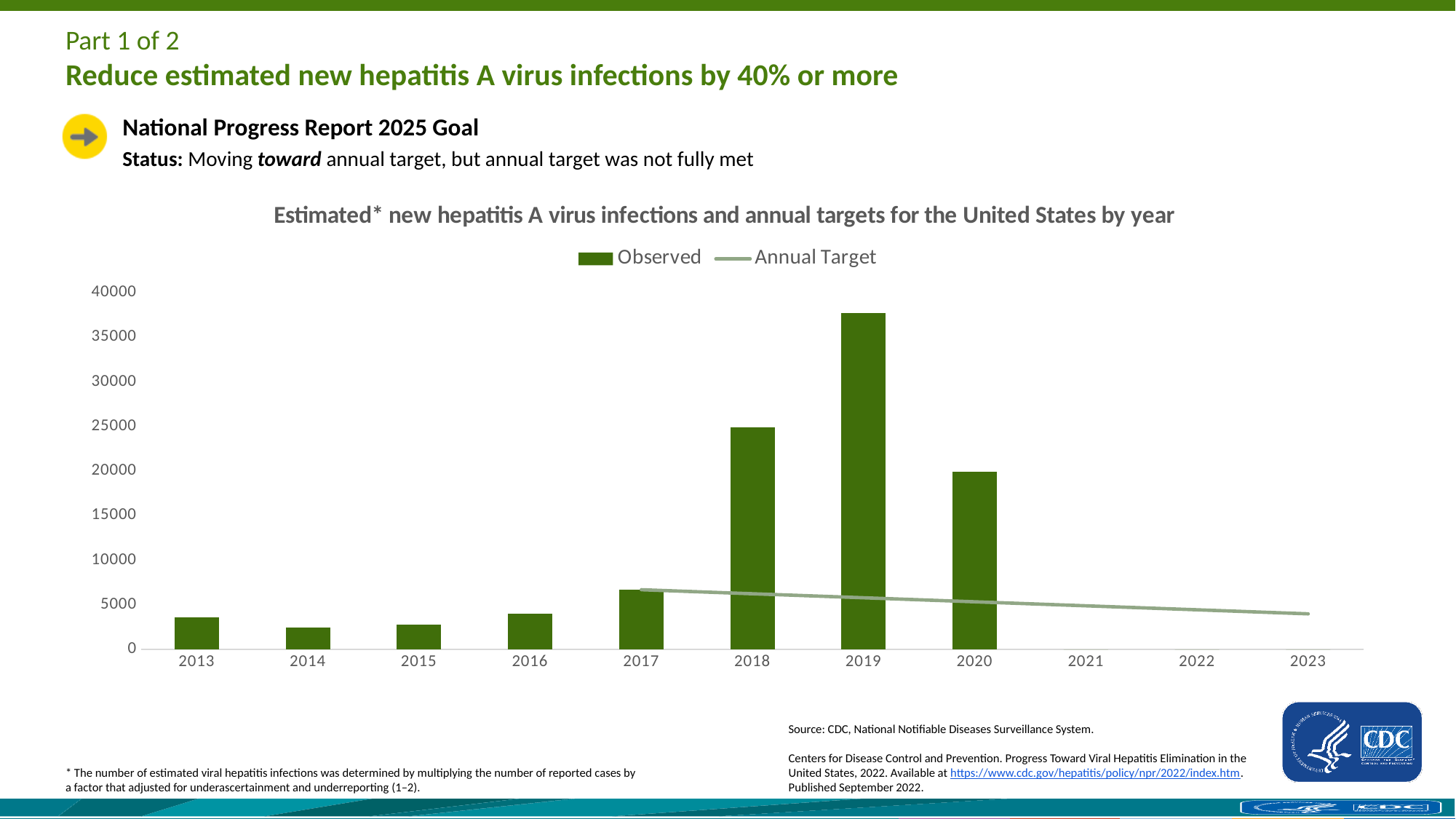
What kind of chart is shown on the slide? Bar chart (with a line for the annual target) Is the observed value for 2017 greater or less than 5000? greater How many years have an Observed bar plotted on the chart? 8 How many series does the chart legend list? 2 Which year has the highest observed value of estimated new hepatitis A virus infections? 2019 Is the observed value for 2019 greater or less than 35000? greater Which is larger, the observed value for 2018 or the observed value for 2020? 2018 Is the observed value for 2020 greater or less than 15000? greater Do the observed values rise or fall from 2017 to 2019? rise What is the title of the chart? Estimated* new hepatitis A virus infections and annual targets for the United States by year